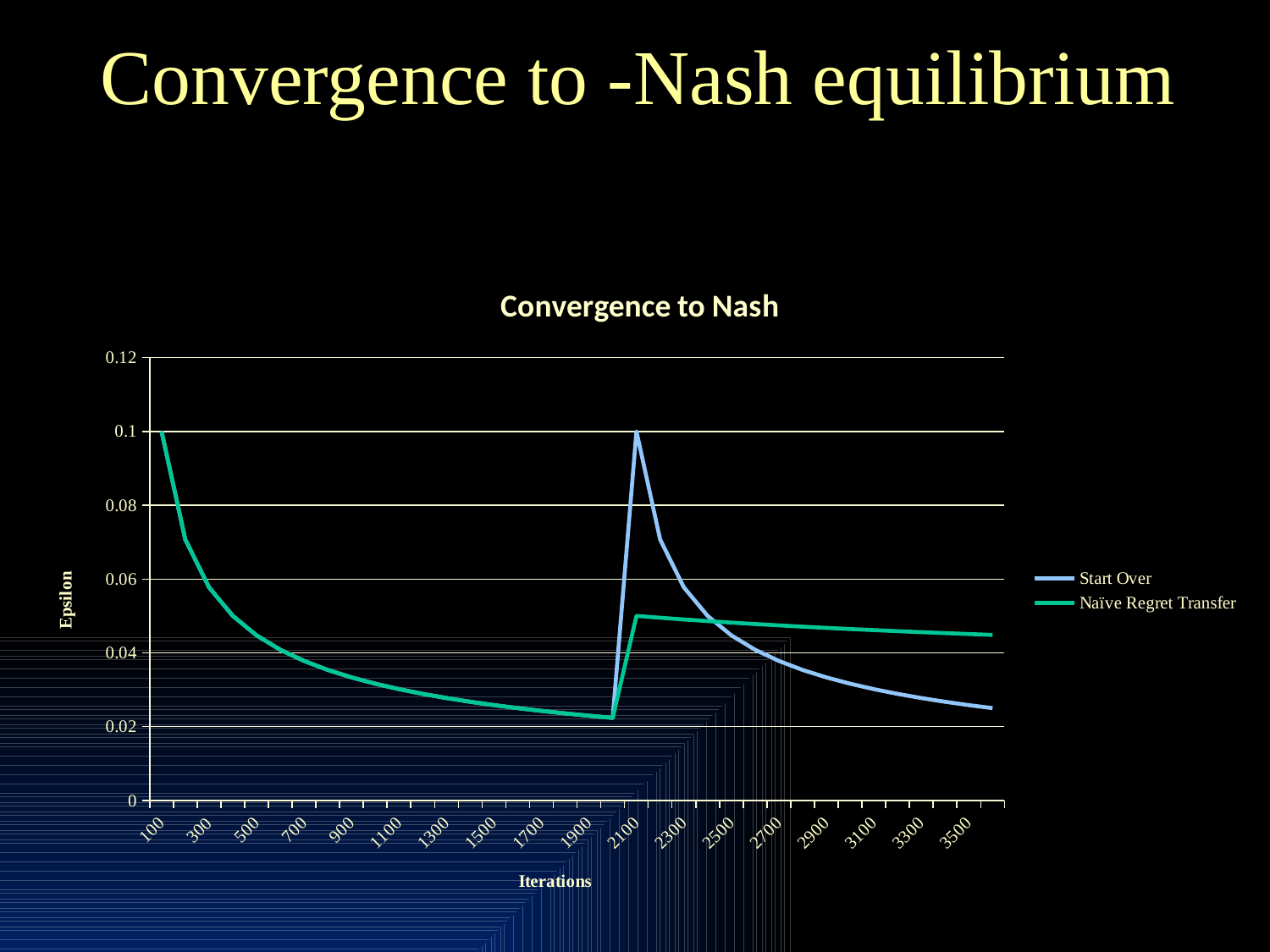
What is the title of the chart? Convergence to Nash What kind of chart is shown on the slide? line chart Between 2100 and 3500 iterations, does the Start Over series rise or fall? fall Is the value for Start Over at 3500 iterations greater or less than 0.04? less How many series does the chart legend list? 2 Is the value for Naïve Regret Transfer at 3500 iterations greater or less than 0.04? greater Is the value for Naïve Regret Transfer at 2100 iterations greater or less than 0.06? less What is the label of the vertical axis? Epsilon At 2100 iterations, which series has the higher Epsilon value, Start Over or Naïve Regret Transfer? Start Over At 3500 iterations, which series has the higher Epsilon value, Start Over or Naïve Regret Transfer? Naïve Regret Transfer